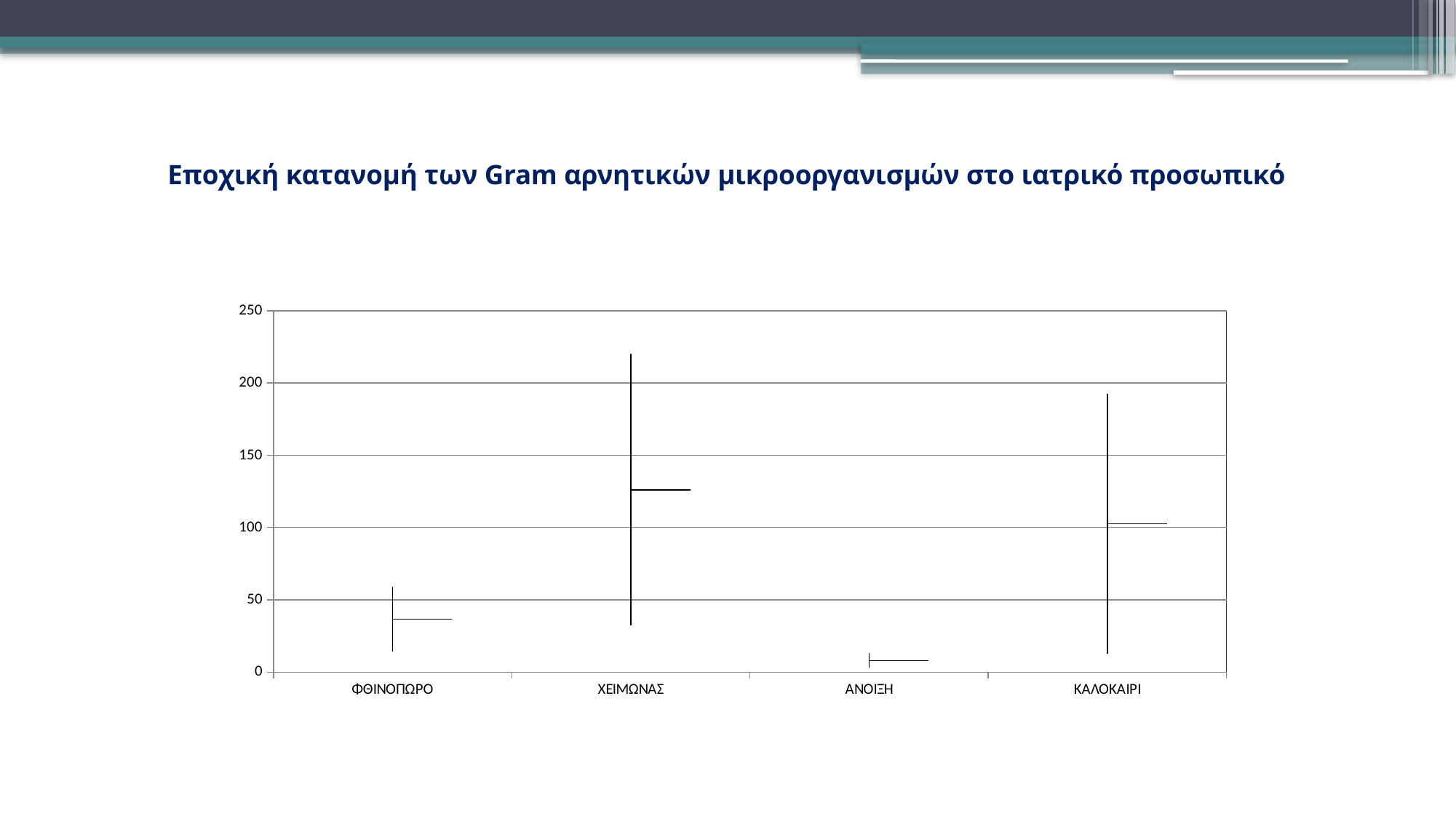
What is the title of the slide above the chart? Εποχική κατανομή των Gram αρνητικών μικροοργανισμών στο ιατρικό προσωπικό Is the upper value for ΚΑΛΟΚΑΙΡΙ greater or less than 200? less Is the horizontal marker value for ΑΝΟΙΞΗ greater or less than 50? less How many categories are shown on the x axis of the chart? 4 Is the upper value for ΧΕΙΜΩΝΑΣ greater or less than 200? greater Which category has the highest upper value in the chart? ΧΕΙΜΩΝΑΣ What is the maximum value shown on the y axis of the chart? 250 Which category has the lowest values in the chart? ΑΝΟΙΞΗ Which has a higher upper value, ΧΕΙΜΩΝΑΣ or ΚΑΛΟΚΑΙΡΙ? ΧΕΙΜΩΝΑΣ Which has a higher horizontal marker value, ΦΘΙΝΟΠΩΡΟ or ΚΑΛΟΚΑΙΡΙ? ΚΑΛΟΚΑΙΡΙ